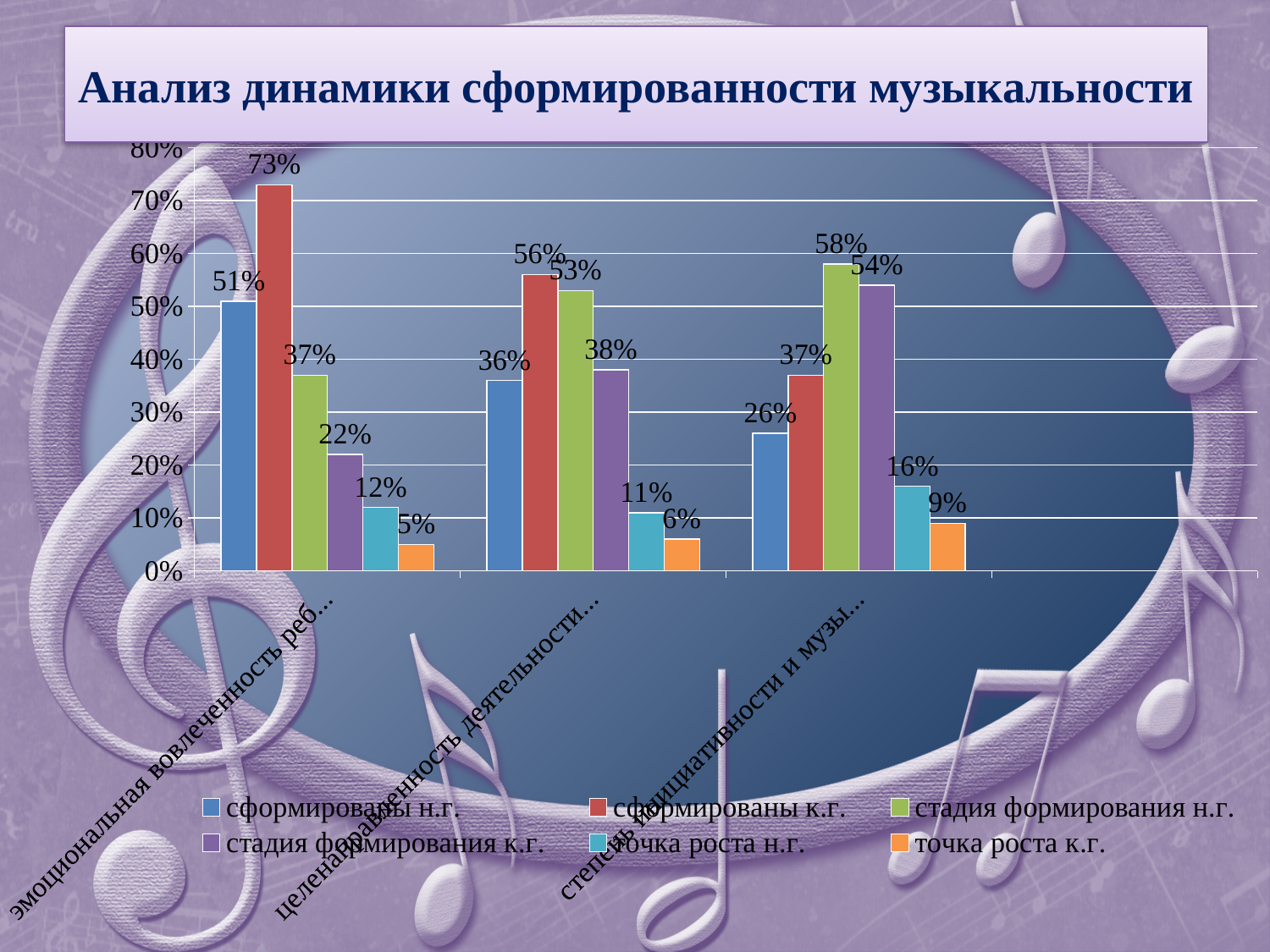
What kind of chart is shown on the slide? bar chart Which bar has the lowest value in the whole chart? точка роста к.г. in the first group (5%) In the first group, what is the difference between 'сформированы к.г.' (73%) and 'сформированы н.г.' (51%)? 22 percentage points Is the value for 'сформированы н.г.' in the second group greater or less than 40%? less Which bar has the highest value in the whole chart? сформированы к.г. in the first group (73%) How many category groups are plotted along the x axis? 3 What is the title of the slide? Анализ динамики сформированности музыкальности How many series does the legend list? 6 In the third group, which is larger: 'стадия формирования н.г.' or 'сформированы к.г.'? стадия формирования н.г. What is the value of 'точка роста н.г.' in the second group, 'целенаправленность деятельности...'? 11% What is the value of 'стадия формирования к.г.' in the third (rightmost) group, 'степень инициативности...'? 54% What is the value of 'сформированы к.г.' in the first (leftmost) group, 'эмоциональная вовлеченность...'? 73%